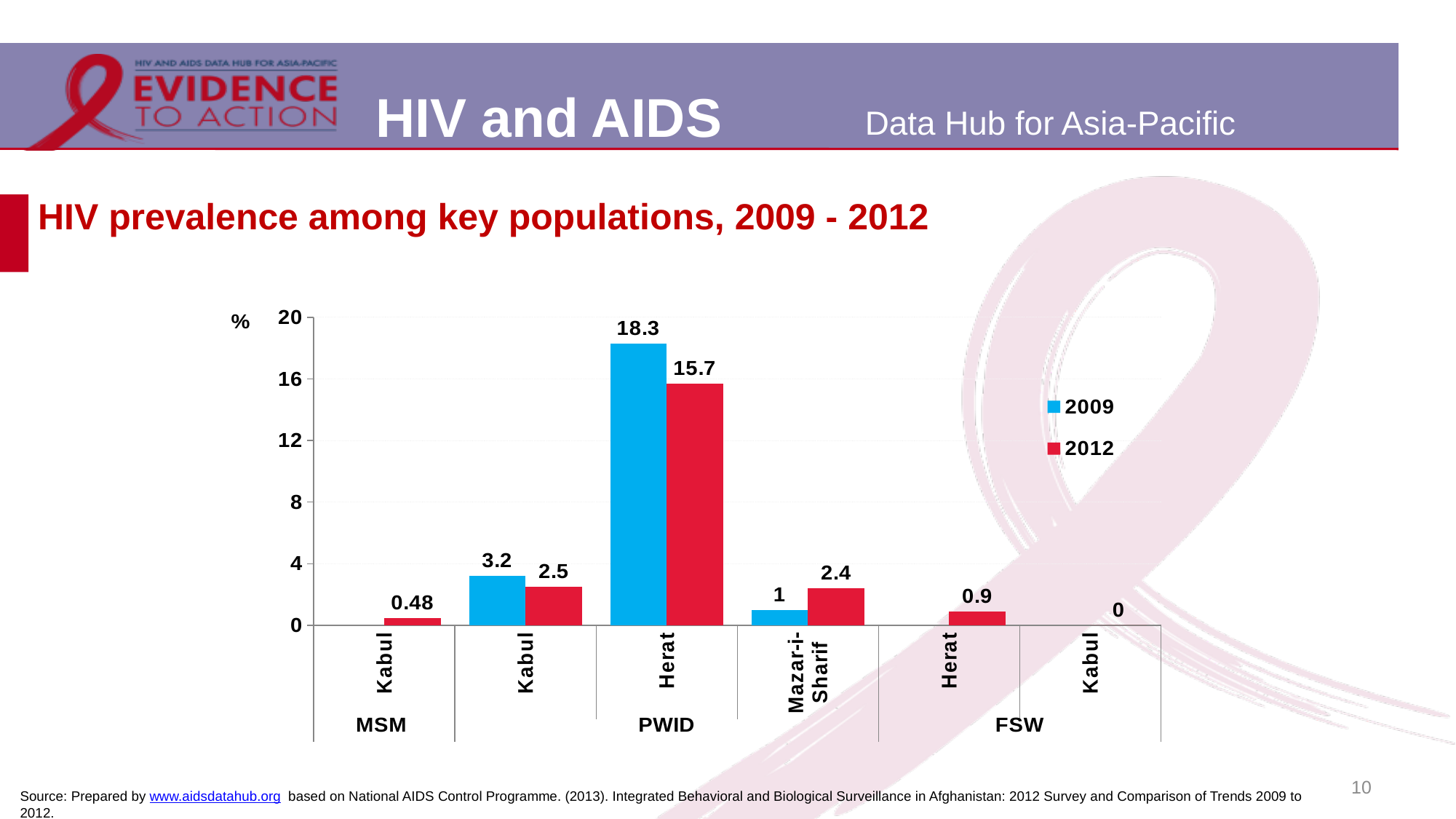
How many series does the legend list? 2 What is the difference between the 2009 and 2012 HIV prevalence among PWID in Herat? 2.6 What is the 2012 HIV prevalence among FSW in Kabul? 0 What is the 2012 HIV prevalence among PWID in Herat? 15.7 Which city and population group has the highest HIV prevalence shown on the chart? PWID in Herat What is the 2009 HIV prevalence among PWID in Herat? 18.3 What is the difference between the 2009 and 2012 HIV prevalence among PWID in Kabul? 0.7 Is the 2009 HIV prevalence among PWID in Herat greater or less than 16? greater What is the 2012 HIV prevalence among MSM in Kabul? 0.48 Among PWID in Mazar-i-Sharif, which year has the higher HIV prevalence, 2009 or 2012? 2012 What is the 2012 HIV prevalence among PWID in Mazar-i-Sharif? 2.4 What type of chart is shown on the slide? Bar chart